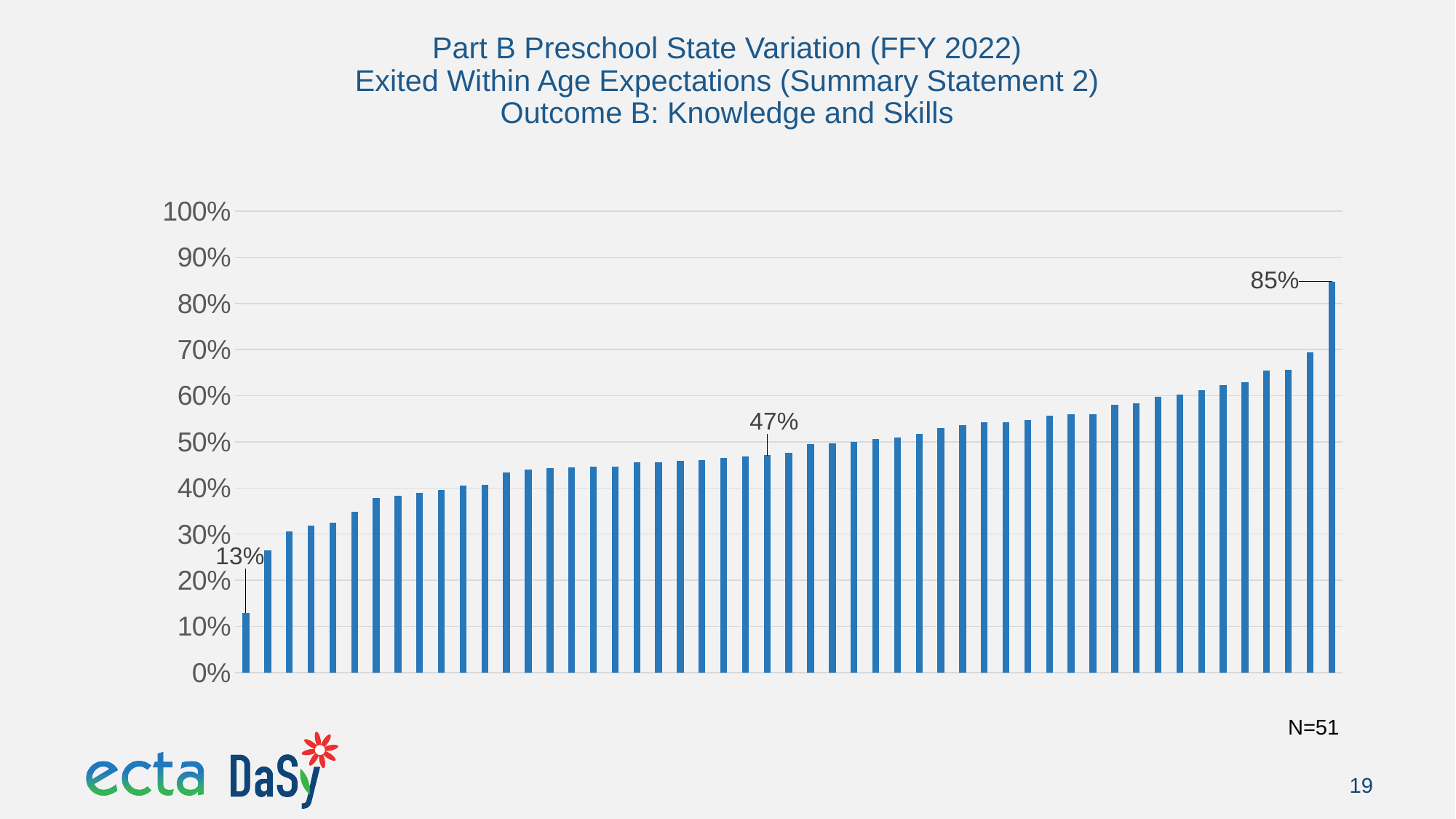
Is the value of the leftmost bar greater or less than 20%? less Do the bar values rise or fall from left to right across the chart? Rise What kind of chart is shown on the slide? Bar chart How many states (N) are represented in the chart? 51 Which is larger, the leftmost bar or the rightmost bar? The rightmost bar What is the lowest value shown in the chart? 13% Is the value of the tallest bar greater or less than 80%? greater What value is labeled on the bar in the middle of the chart? 47% What is the highest value shown in the chart? 85% Which fiscal year does the chart title refer to? FFY 2022 What is the difference between the highest labeled value (85%) and the lowest labeled value (13%)? 72 percentage points Which outcome does the chart title say the data is for? Outcome B: Knowledge and Skills